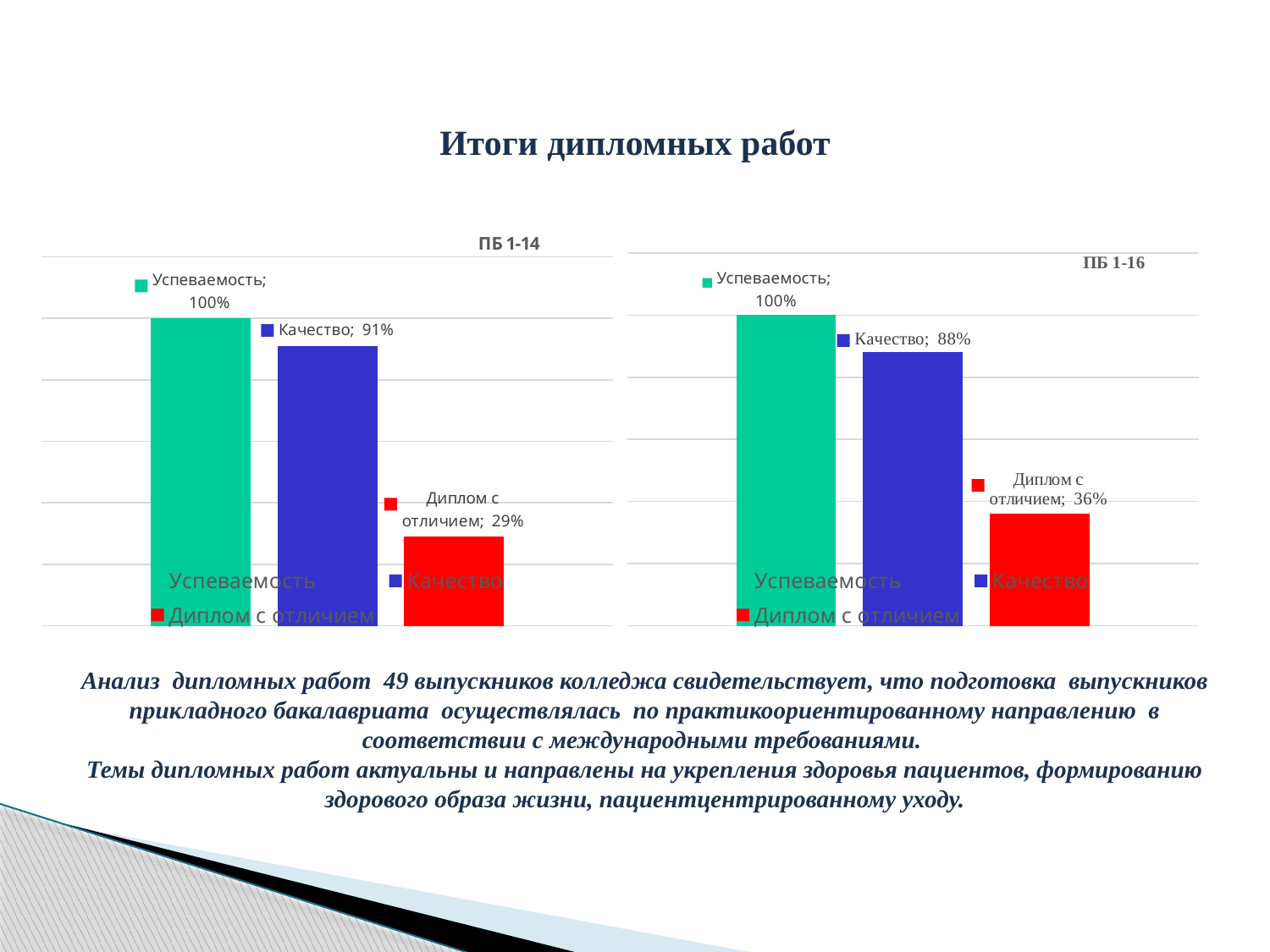
In the ПБ 1-16 chart, what is the value for Диплом с отличием? 36% In the ПБ 1-14 chart, what is the value for Качество? 91% In the ПБ 1-16 chart, which category has the highest value? Успеваемость In the ПБ 1-16 chart, what is the value for Качество? 88% In the ПБ 1-14 chart, what is the difference between Качество and Диплом с отличием? 62% Which chart has the larger value for Диплом с отличием, ПБ 1-14 or ПБ 1-16? ПБ 1-16 In the ПБ 1-14 chart, which category has the lowest value? Диплом с отличием How many entries does the legend of the ПБ 1-16 chart list? 3 In the ПБ 1-14 chart, what is the value for Успеваемость? 100% In the ПБ 1-16 chart, what is the difference between Успеваемость and Качество? 12% How many bars are plotted in the ПБ 1-14 chart? 3 What kind of chart is the ПБ 1-14 chart? Bar chart